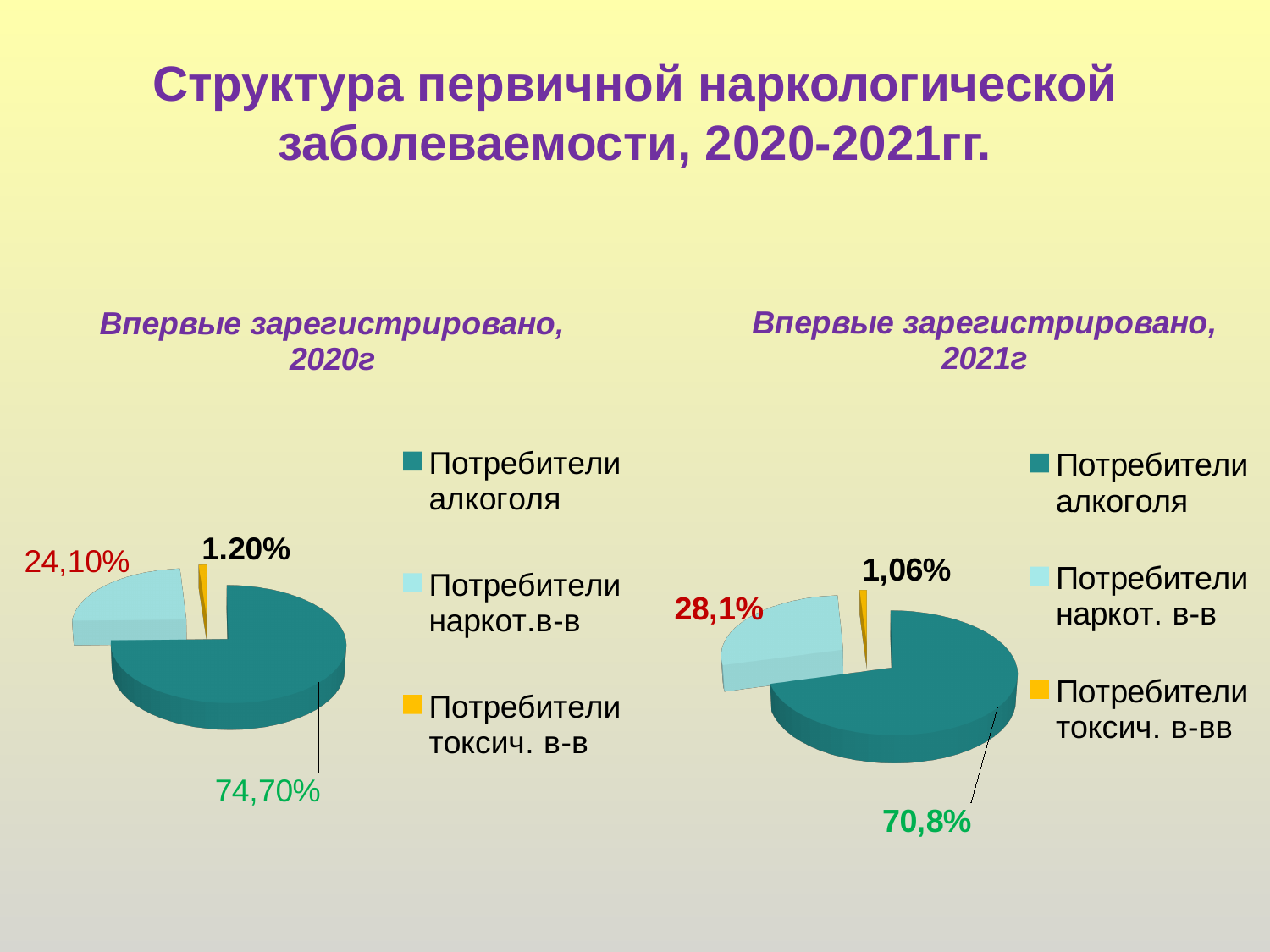
In the chart titled "Впервые зарегистрировано, 2020г", what share is shown for Потребители наркот.в-в? 24,10% What type of chart is the one titled "Впервые зарегистрировано, 2021г"? Pie chart In the chart titled "Впервые зарегистрировано, 2020г", what colour is the slice for Потребители токсич. в-в? Yellow/orange In the chart titled "Впервые зарегистрировано, 2020г", what share is shown for Потребители алкоголя? 74,70% In the chart titled "Впервые зарегистрировано, 2020г", what share is shown for Потребители токсич. в-в? 1.20% In the chart titled "Впервые зарегистрировано, 2020г", which category has the largest slice? Потребители алкоголя In the chart titled "Впервые зарегистрировано, 2021г", what share is shown for Потребители алкоголя? 70,8% In the chart titled "Впервые зарегистрировано, 2021г", what share is shown for Потребители токсич. в-вв? 1,06% In the chart titled "Впервые зарегистрировано, 2021г", which category has the smallest slice? Потребители токсич. в-вв In the chart titled "Впервые зарегистрировано, 2021г", what share is shown for Потребители наркот. в-в? 28,1% Which is larger: the share for Потребители наркот.в-в in the 2020 chart or the share for Потребители наркот. в-в in the 2021 chart? 2021 chart (28,1%) How many categories does the legend of the chart titled "Впервые зарегистрировано, 2020г" list? 3